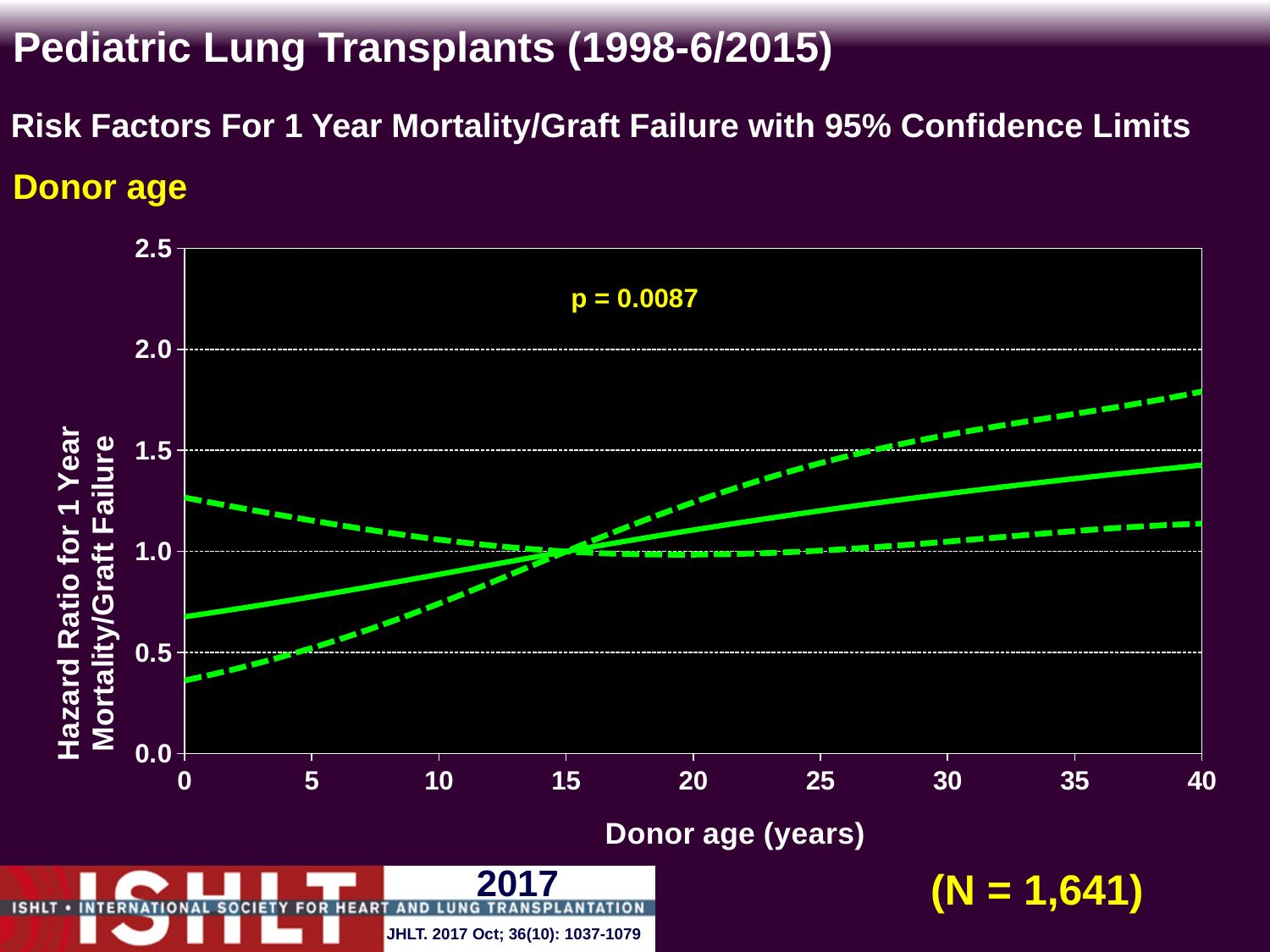
Is the upper dashed confidence limit at donor age 40 greater or less than 1.5? greater Which has the higher hazard ratio on the solid line: donor age 0 or donor age 40? donor age 40 Is the lower dashed confidence limit at donor age 0 greater or less than 0.5? less What kind of chart is shown on the slide? line chart Is the value of the solid hazard ratio line at donor age 40 greater or less than 1.0? greater How many lines are plotted on the chart? 3 Does the solid line (hazard ratio) rise or fall as donor age increases from 0 to 40 years? rise What sample size (N) is shown on the slide? N = 1,641 What p-value is printed on the chart? p = 0.0087